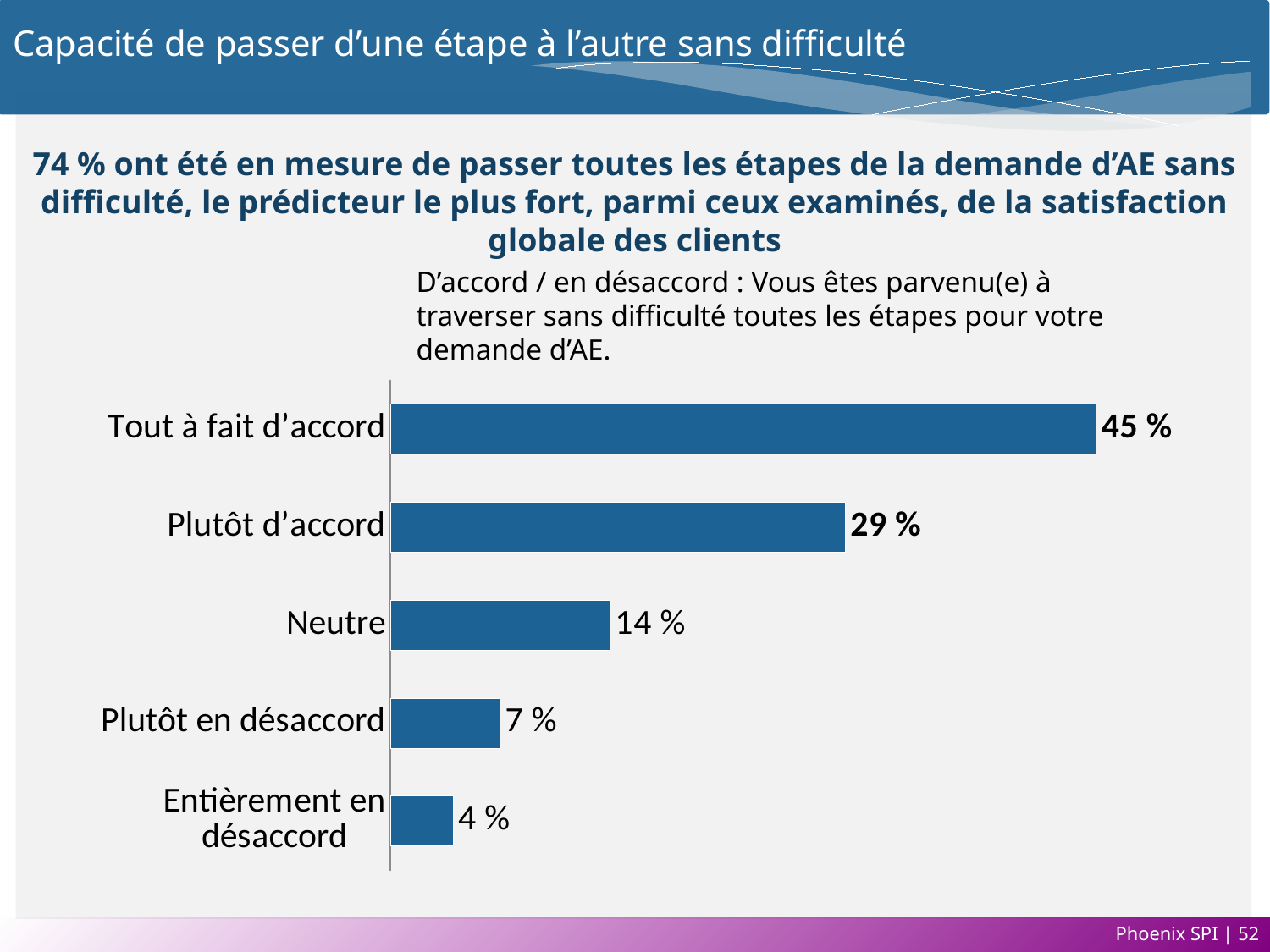
What is the value for "Neutre"? 14 % What kind of chart is shown on the slide? Bar chart What is the difference between the values for "Tout à fait d'accord" and "Plutôt d'accord"? 16 % What is the value for "Plutôt en désaccord"? 7 % Which is larger, the value for "Neutre" or the value for "Plutôt en désaccord"? Neutre Which category has the highest value? Tout à fait d'accord How many categories are shown in the chart? 5 What is the value for "Tout à fait d'accord"? 45 % What is the value for "Entièrement en désaccord"? 4 % Which category has the lowest value? Entièrement en désaccord What is the combined value of "Tout à fait d'accord" and "Plutôt d'accord"? 74 % What is the value for "Plutôt d'accord"? 29 %